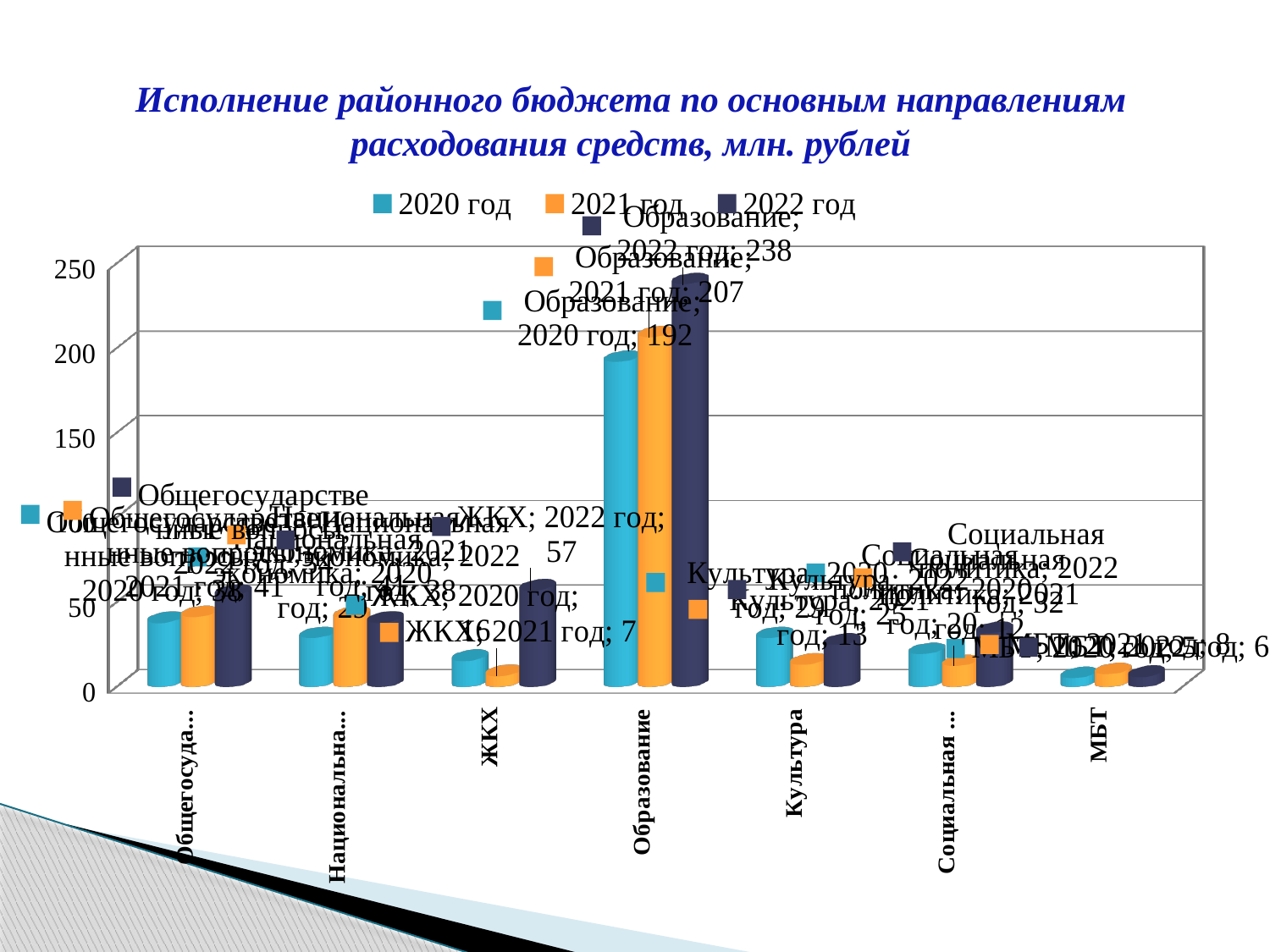
What is the value for ЖКХ in 2021 год? 7 What kind of chart is shown on the slide? bar chart Do the values for Образование rise or fall from 2020 год to 2022 год? rise Which category has the highest values across all three years? Образование What is the value for ЖКХ in 2022 год? 57 What is the value for Образование in 2022 год? 238 What is the difference between the 2022 год and 2020 год values for Образование? 46 Which is larger for ЖКХ: the 2022 год value or the 2021 год value? 2022 год What is the value for Образование in 2020 год? 192 Which category has the lowest values across all three years? МБТ How many expenditure categories are shown on the x axis? 7 How many series does the legend list? 3